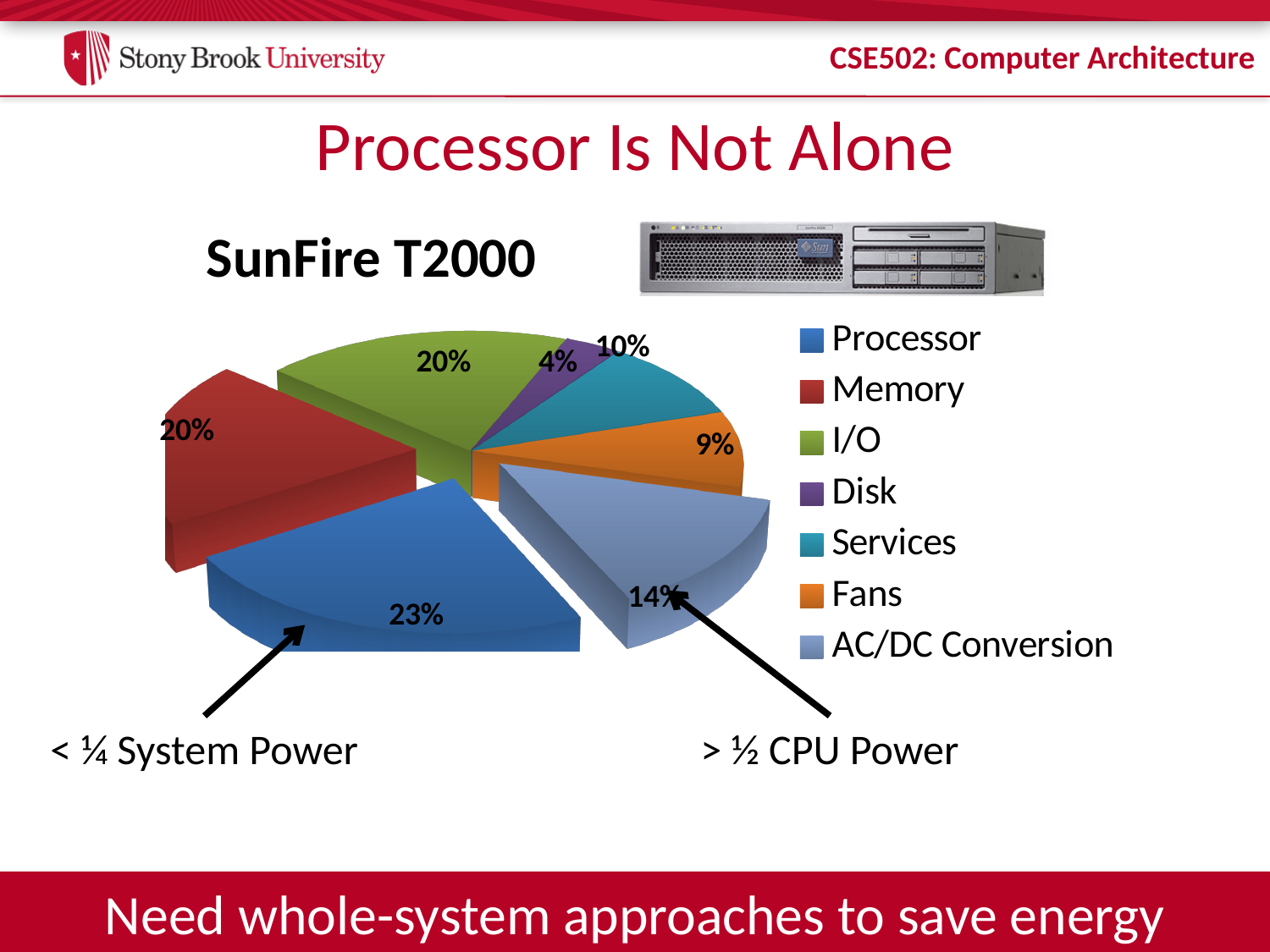
What percentage is shown for Memory? 20% What type of chart is shown on the slide? pie chart What percentage of system power does the Processor account for? 23% Which system is the pie chart about, according to the label above it? SunFire T2000 What is the difference in percentage points between Processor and AC/DC Conversion? 9 What percentage is shown for AC/DC Conversion? 14% What percentage is shown for Fans? 9% Which category has the smallest share of the pie? Disk How many categories does the legend list? 7 Which is larger, the share for Services or the share for Fans? Services Which category has the largest share of the pie? Processor What percentage is shown for Services? 10%